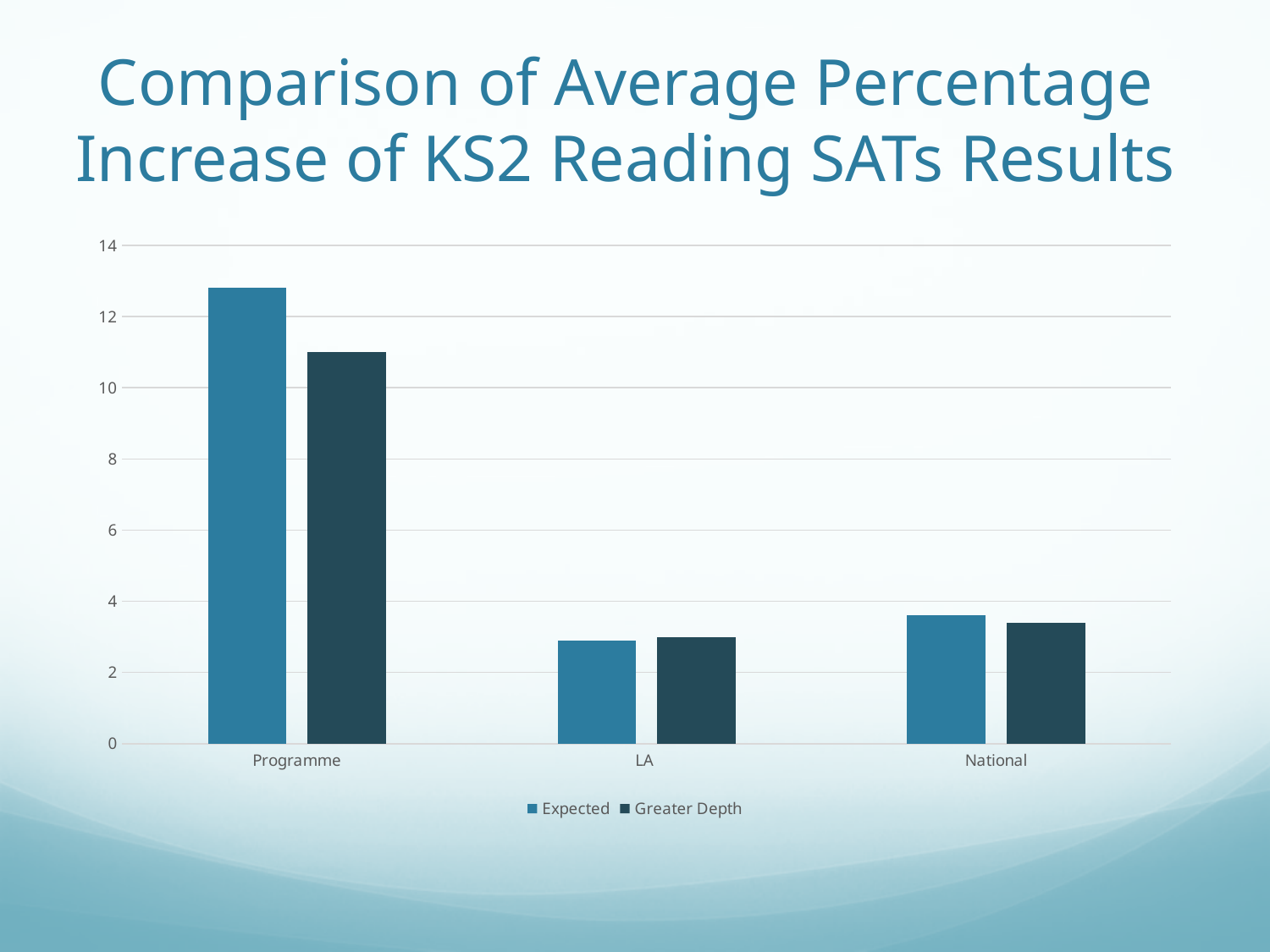
How many series does the chart's legend list? 2 How many categories are shown on the x axis of the chart? 3 What kind of chart is shown on the slide? Bar chart Is the Expected value for LA greater or less than 4? less For Programme, which is larger: the Expected value or the Greater Depth value? Expected Which category has the lowest value for the Expected series? LA Which category has the highest value for the Expected series? Programme What are the two series named in the chart's legend? Expected and Greater Depth What is the title of the chart on the slide? Comparison of Average Percentage Increase of KS2 Reading SATs Results Which category has the highest value for the Greater Depth series? Programme Is the Expected value for Programme greater or less than 12? greater Is the Greater Depth value for Programme greater or less than 10? greater